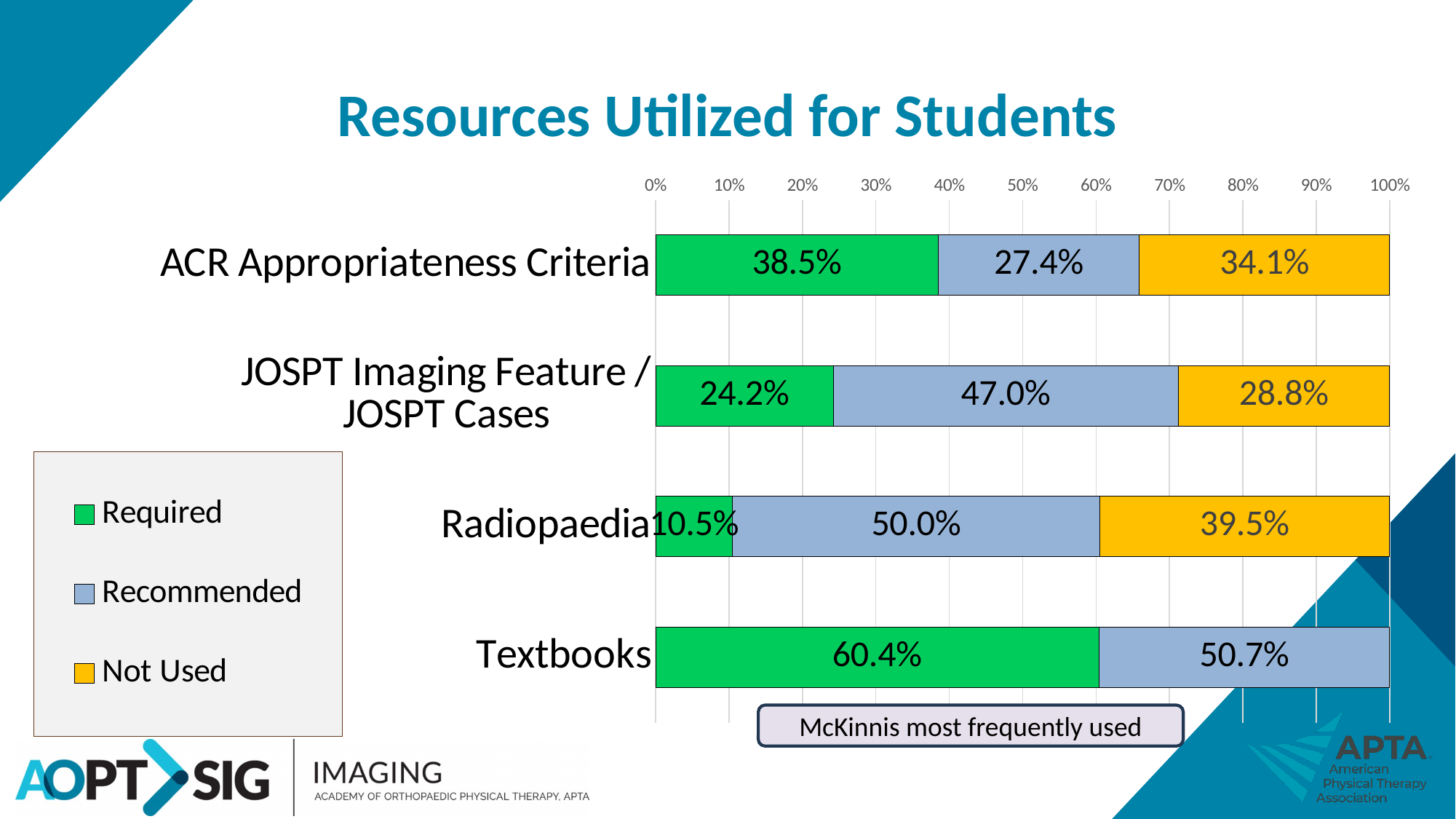
What is the Not Used value for Radiopaedia? 39.5% What is the Required value for Textbooks? 60.4% What percentage of respondents reported the ACR Appropriateness Criteria as Required? 38.5% What is the Recommended value for JOSPT Imaging Feature / JOSPT Cases? 47.0% How many series does the legend list? 3 Which colour represents the Not Used series in the legend? Yellow Which resource has the lowest Required percentage? Radiopaedia Which resource has the highest Required percentage? Textbooks How many resources are shown on the chart? 4 What is the difference between the Not Used values for Radiopaedia and ACR Appropriateness Criteria? 5.4% Which is larger: the Recommended value for Radiopaedia or the Recommended value for ACR Appropriateness Criteria? Radiopaedia What kind of chart is shown on the slide? Stacked bar chart